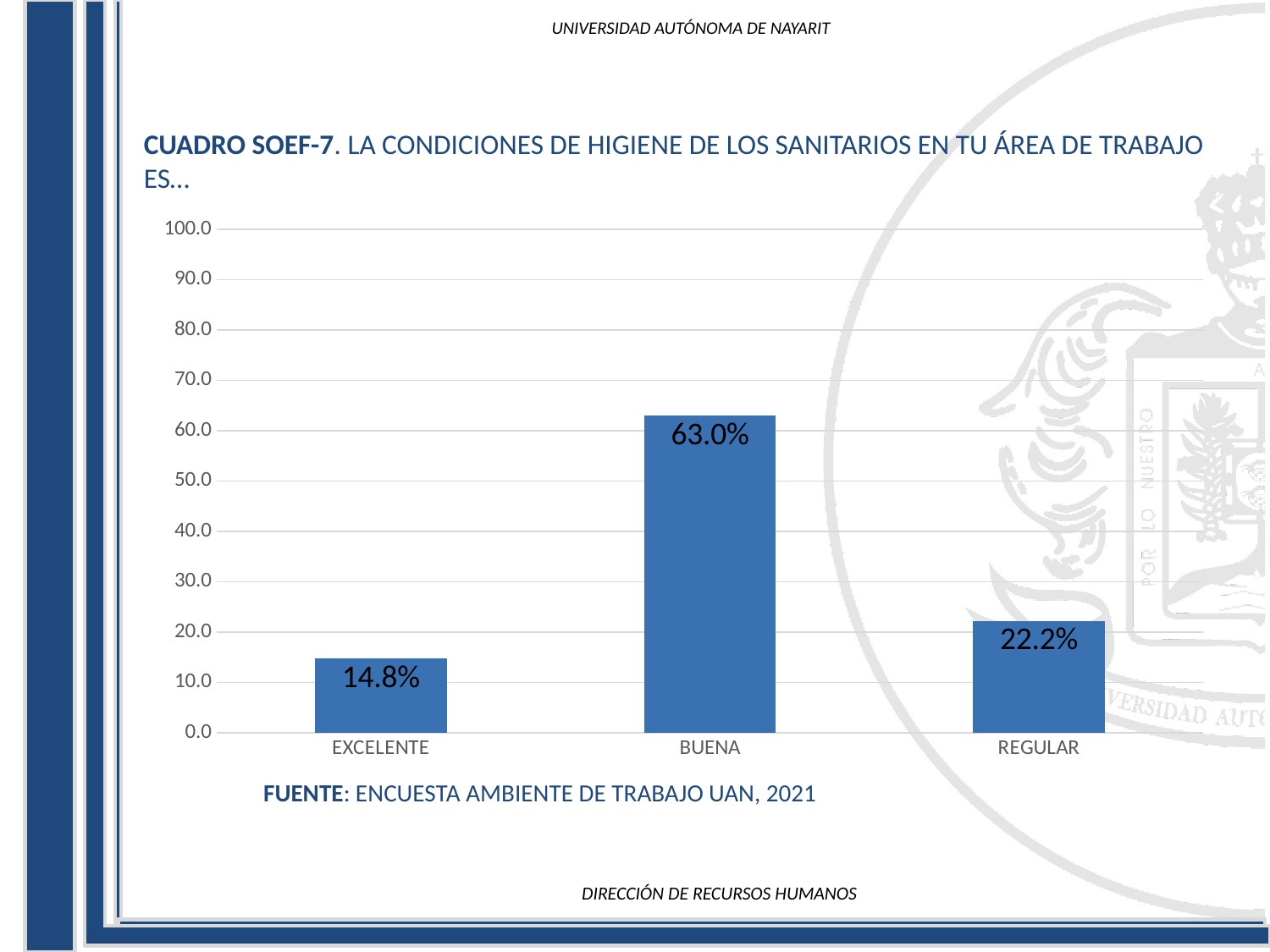
Which category has the lowest value? EXCELENTE What source is cited below the chart? ENCUESTA AMBIENTE DE TRABAJO UAN, 2021 What is the value for BUENA? 63.0% How many categories are shown on the x axis? 3 Is the value for BUENA greater or less than 50.0? greater Which is larger, the value for REGULAR or the value for EXCELENTE? REGULAR What is the value for REGULAR? 22.2% What kind of chart is shown on the slide? Bar chart What is the difference between the values for BUENA and REGULAR? 40.8% What is the value for EXCELENTE? 14.8% Which category has the highest value? BUENA What is the difference between the values for REGULAR and EXCELENTE? 7.4%